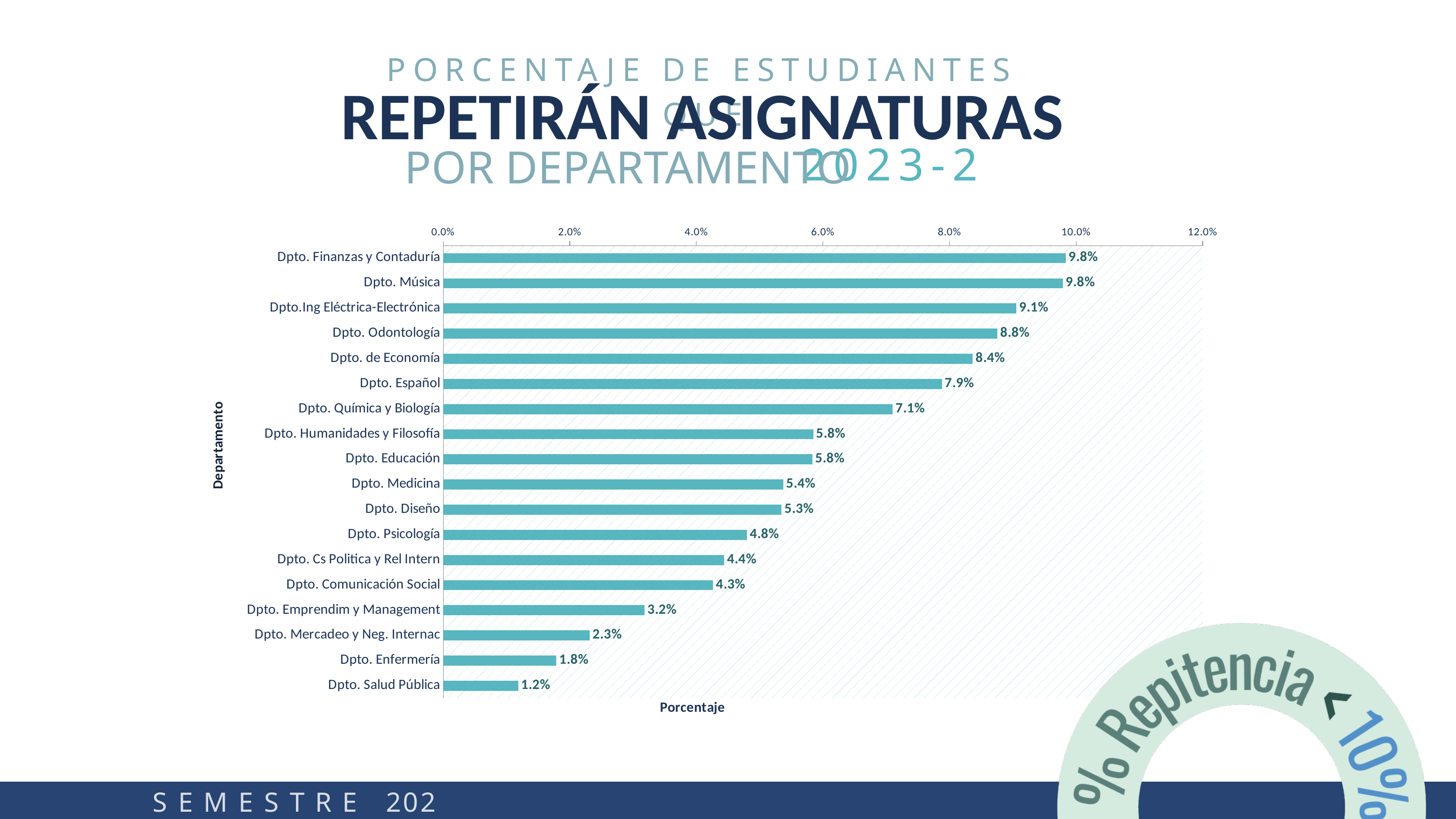
What kind of chart is shown on the slide? bar chart What is the difference between the values for Dpto. Odontología and Dpto. de Economía? 0.4% How many departments are shown in the chart? 18 What is the value for Dpto. Enfermería? 1.8% Is the value for Dpto.Ing Eléctrica-Electrónica greater or less than 8.0%? greater What is the label of the horizontal axis? Porcentaje Which is larger, the value for Dpto. Emprendim y Management or the value for Dpto. Comunicación Social? Dpto. Comunicación Social What is the value for Dpto. Psicología? 4.8% Which department has the lowest percentage? Dpto. Salud Pública What is the value for Dpto. Química y Biología? 7.1% What is the difference between the values for Dpto. Español and Dpto. Química y Biología? 0.8% What is the value for Dpto. Odontología? 8.8%